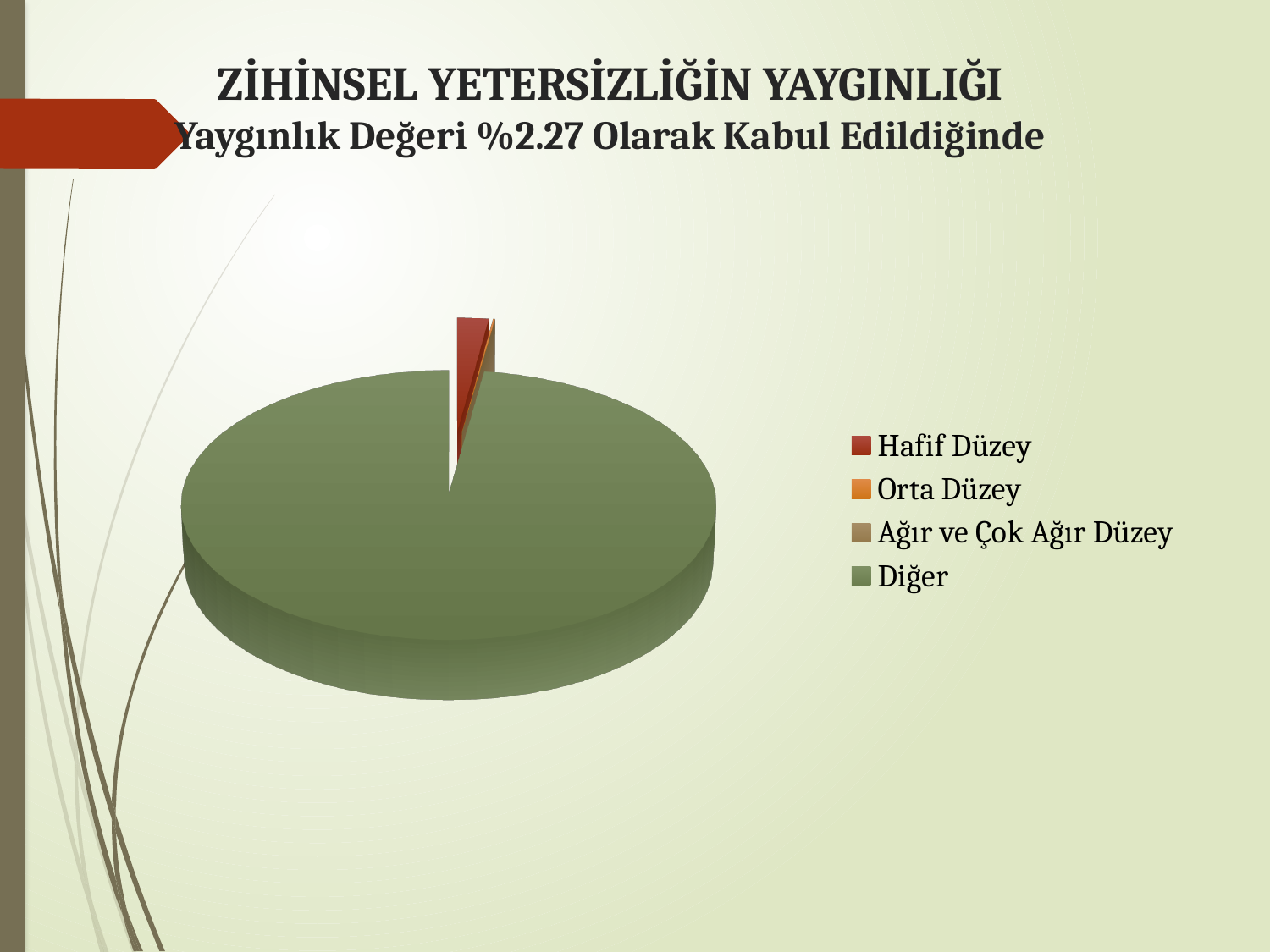
How many categories does the pie chart's legend list? 4 Which slice is larger, Hafif Düzey or Orta Düzey? Hafif Düzey Which slice is larger, Hafif Düzey or Diğer? Diğer Which category is shown in green on the pie chart? Diğer Which category has the largest slice of the pie chart? Diğer Which category is shown in dark red on the pie chart? Hafif Düzey What kind of chart is shown on the slide? pie chart Is the Diğer slice more or less than half of the pie? more